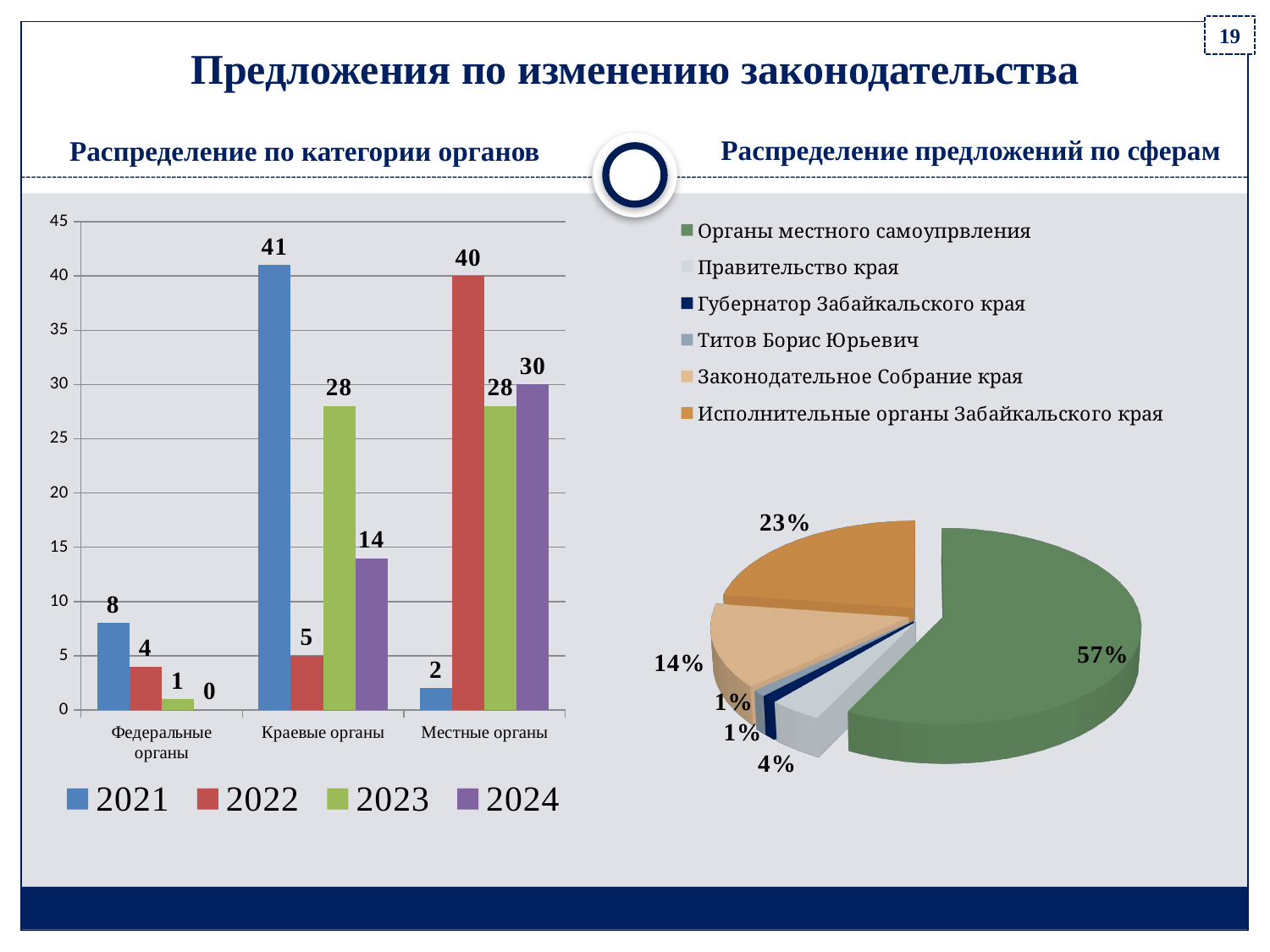
How many series does the legend of the bar chart 'Распределение по категории органов' list? 4 In the bar chart 'Распределение по категории органов', which year has the highest value in the 'Местные органы' category? 2022 In the pie chart 'Распределение предложений по сферам', what share does 'Органы местного самоупрвления' have? 57% In the bar chart 'Распределение по категории органов', what is the difference between the 2024 values for 'Местные органы' and 'Краевые органы'? 16 In the bar chart 'Распределение по категории органов', which year has the lowest value in the 'Краевые органы' category? 2022 In the pie chart 'Распределение предложений по сферам', what share does 'Исполнительные органы Забайкальского края' have? 23% In the bar chart 'Распределение по категории органов', what is the value for 2022 in the 'Местные органы' category? 40 In the bar chart 'Распределение по категории органов', what is the value for 2021 in the 'Краевые органы' category? 41 How many categories are shown on the x axis of the bar chart 'Распределение по категории органов'? 3 In the bar chart 'Распределение по категории органов', what is the value for 2024 in the 'Федеральные органы' category? 0 What kind of chart is 'Распределение предложений по сферам'? Pie chart In the bar chart 'Распределение по категории органов', which is larger: the 2021 value for 'Федеральные органы' or the 2021 value for 'Местные органы'? Федеральные органы